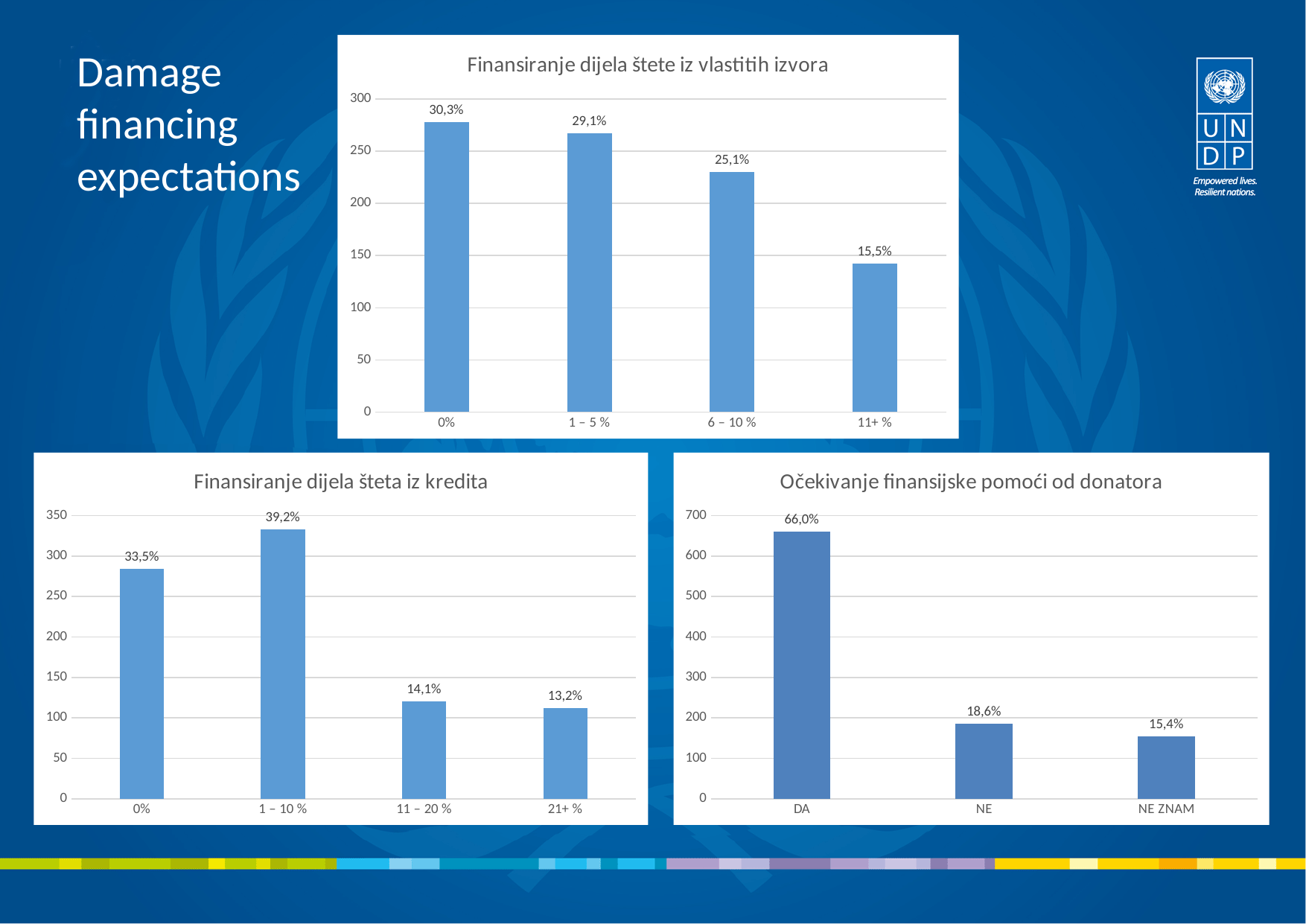
What type of chart is the one titled "Očekivanje finansijske pomoći od donatora"? Bar chart In the chart titled "Očekivanje finansijske pomoći od donatora", what is the data label for "NE ZNAM"? 15,4% In the chart titled "Očekivanje finansijske pomoći od donatora", is the bar for "DA" greater or less than 600 on the vertical axis? greater In the chart titled "Očekivanje finansijske pomoći od donatora", how many categories are shown? 3 In the chart titled "Finansiranje dijela štete iz vlastitih izvora", which category has the lowest value? 11+ % In the chart titled "Finansiranje dijela štete iz vlastitih izvora", is the bar for "0%" greater or less than 250 on the vertical axis? greater In the chart titled "Finansiranje dijela šteta iz kredita", what is the data label for the "1 – 10 %" category? 39,2% In the chart titled "Finansiranje dijela šteta iz kredita", which is larger: the value for "0%" or the value for "11 – 20 %"? 0% In the chart titled "Finansiranje dijela štete iz vlastitih izvora", how many categories are shown on the x axis? 4 In the chart titled "Finansiranje dijela štete iz vlastitih izvora", what is the data label for the "0%" category? 30,3% In the chart titled "Finansiranje dijela šteta iz kredita", which category has the highest value? 1 – 10 % In the chart titled "Finansiranje dijela šteta iz kredita", what is the difference in percentage points between the labels for "1 – 10 %" and "21+ %"? 26,0 percentage points